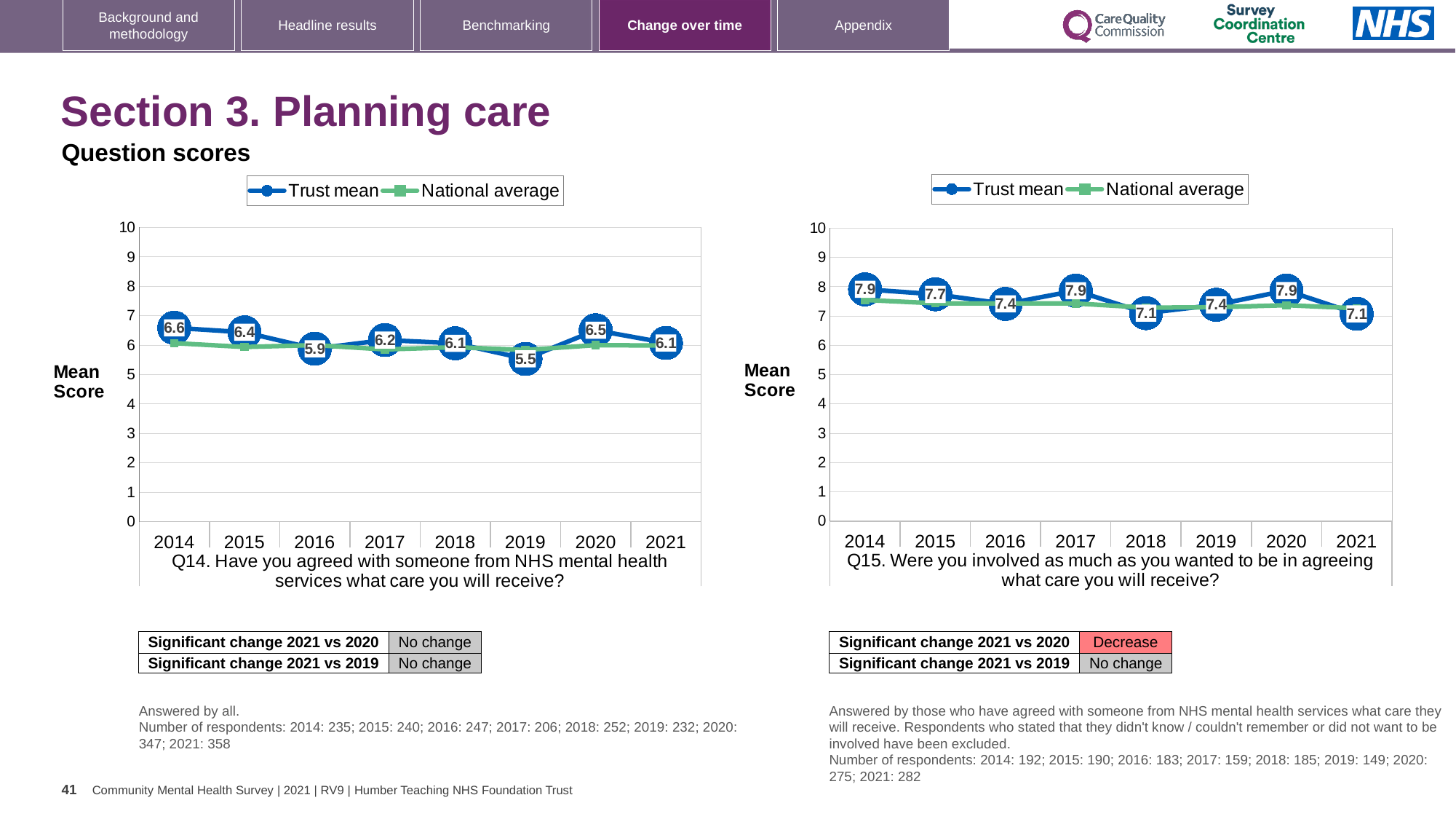
How many series does the legend of the Q15 chart on the right list? 2 What kind of chart is the Q14 chart on the left? Line chart In the Q14 chart on the left, what is the difference between the Trust mean for 2020 and 2019? 1.0 In the Q14 chart on the left, which year has the highest Trust mean? 2014 In the Q15 chart on the right, what is the difference between the Trust mean for 2014 and 2021? 0.8 In the Q15 chart on the right, what is the Trust mean for 2015? 7.7 In the Q15 chart on the right, what is the Trust mean for 2018? 7.1 In the Q15 chart on the right, which is larger, the Trust mean for 2020 or for 2021? 2020 In the Q14 chart on the left, what is the Trust mean for 2021? 6.1 In the Q14 chart on the left, what is the Trust mean for 2019? 5.5 In the Q14 chart on the left, which year has the lowest Trust mean? 2019 How many years are plotted on the x axis of the Q14 chart on the left? 8